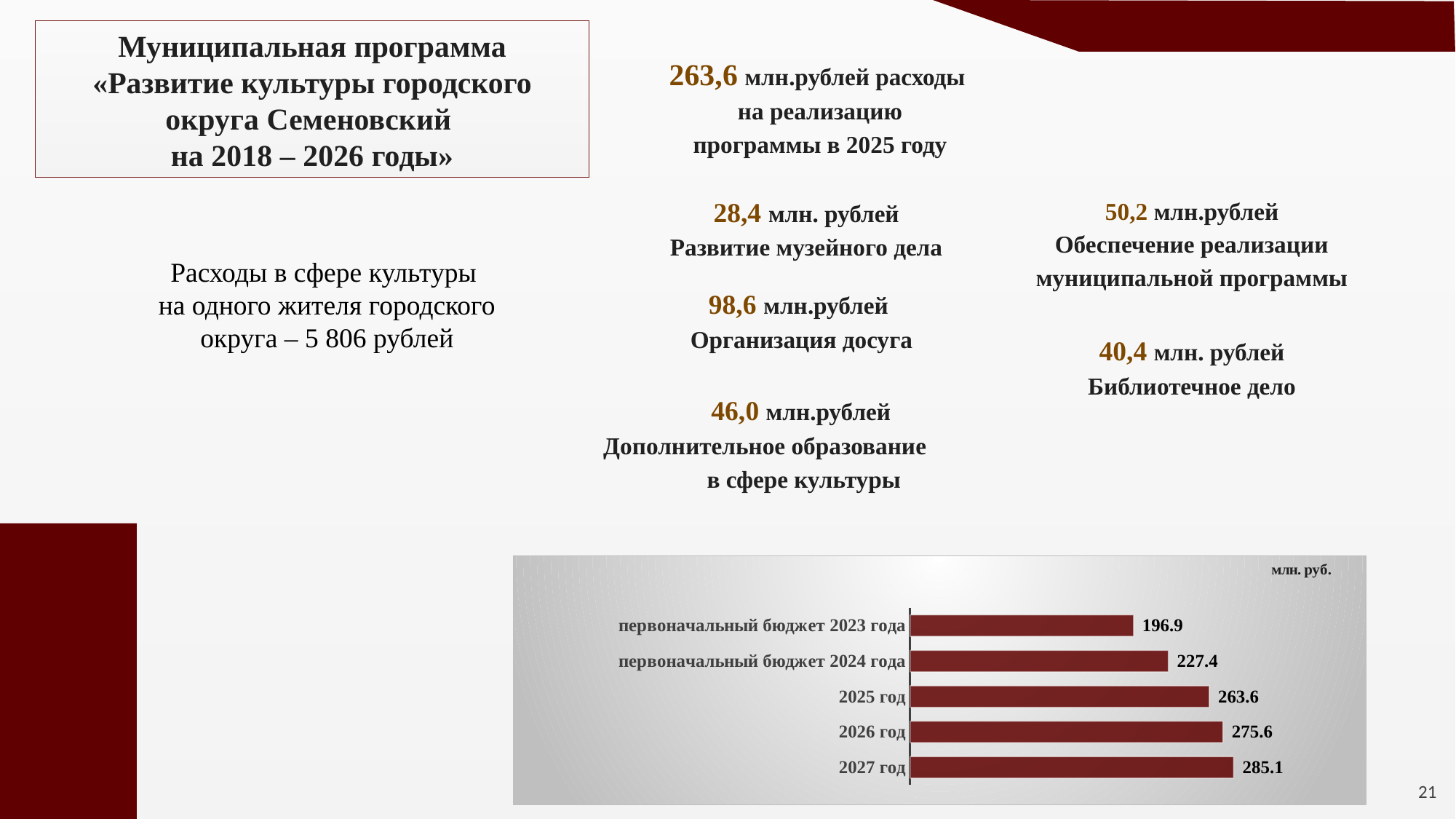
What is the value for «первоначальный бюджет 2023 года» in the bar chart? 196.9 What is the value for «2027 год» in the bar chart? 285.1 Do the values in the bar chart rise or fall from the 2023 initial budget to 2027? rise How many categories (bars) are shown in the bar chart? 5 Which category has the lowest value in the bar chart? первоначальный бюджет 2023 года Which is larger in the bar chart: the value for «2026 год» or for «первоначальный бюджет 2024 года»? 2026 год Which category has the highest value in the bar chart? 2027 год What is the difference between the values for «первоначальный бюджет 2024 года» and «первоначальный бюджет 2023 года»? 30.5 What type of chart is shown at the bottom of the slide? bar chart What is the difference between the values for «2026 год» and «2025 год» in the bar chart? 12.0 What is the value for «2025 год» in the bar chart? 263.6 What unit is indicated in the top right corner of the bar chart? млн. руб.